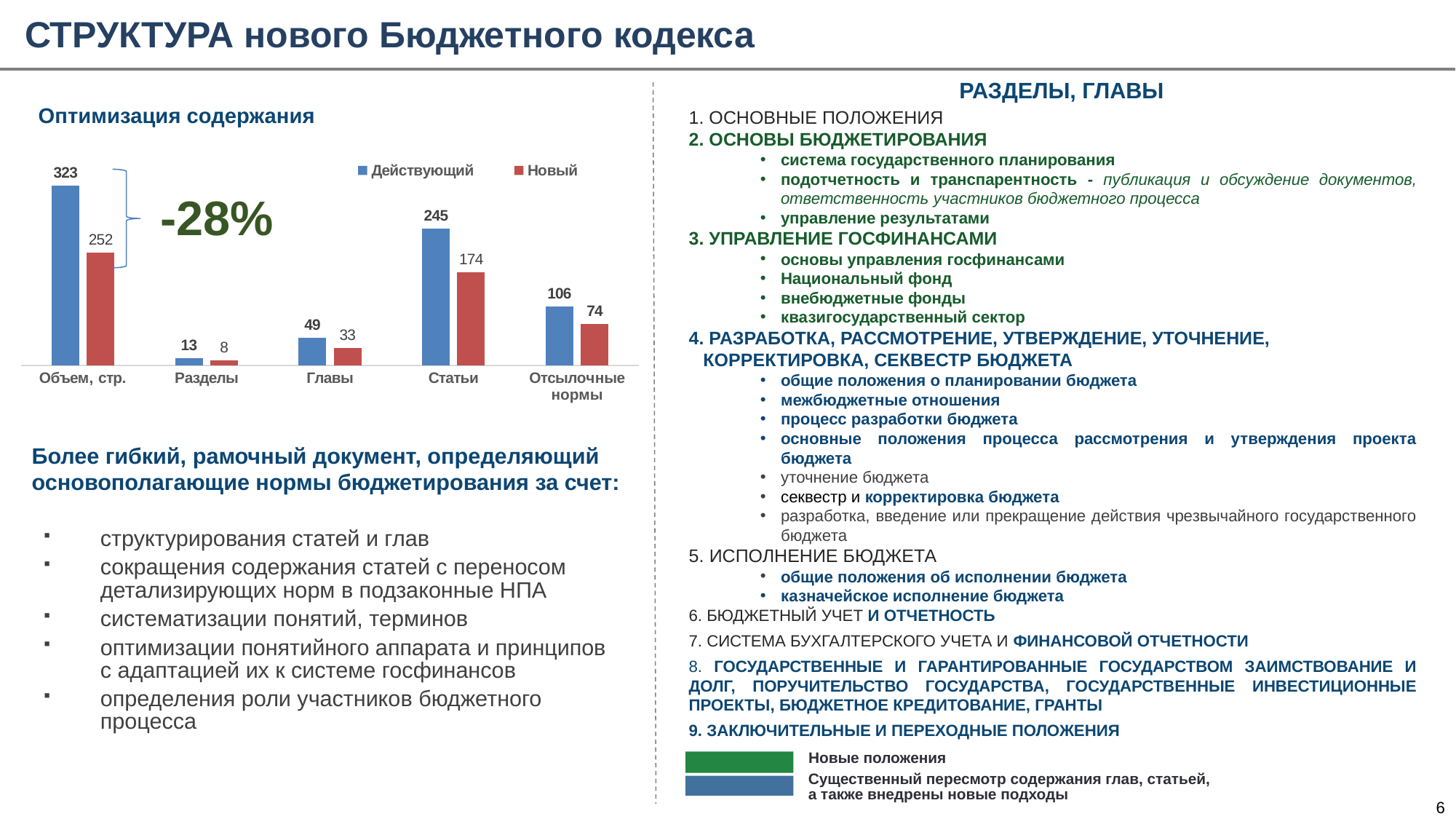
Which category has the lowest value for the «Новый» series? Разделы How many categories are shown on the x axis of the «Оптимизация содержания» chart? 5 What is the value of «Действующий» for «Отсылочные нормы»? 106 What is the value of «Действующий» for «Объем, стр.»? 323 Which is larger for «Статьи»: «Действующий» or «Новый»? Действующий What is the value of «Новый» for «Разделы»? 8 Which category has the highest value for the «Действующий» series? Объем, стр. What is the difference between «Действующий» and «Новый» for «Главы»? 16 What percentage change is annotated next to the «Объем, стр.» bars? -28% What is the value of «Новый» for «Статьи»? 174 How many series does the legend of the «Оптимизация содержания» chart list? 2 What type of chart is shown under the heading «Оптимизация содержания»? bar chart